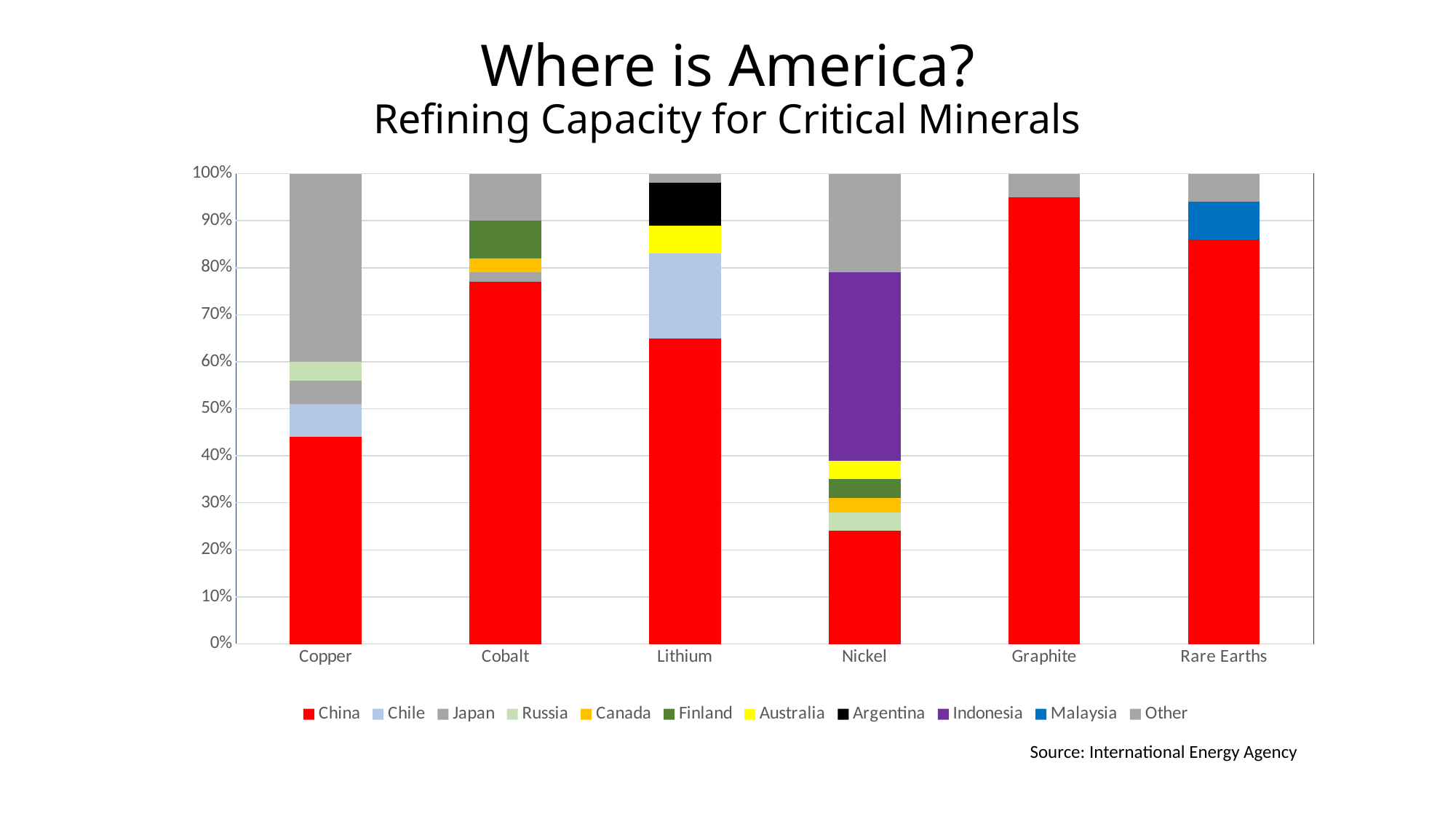
Is China's share of lithium refining capacity greater or less than 60%? greater Is China's share of copper refining capacity greater or less than 50%? less For which mineral is China's share of refining capacity the highest? Graphite What kind of chart is shown on the slide? Stacked bar chart Is China's share of nickel refining capacity greater or less than 30%? less What is the subtitle of the chart? Refining Capacity for Critical Minerals Which is larger: China's share of cobalt refining capacity or China's share of lithium refining capacity? Cobalt How many series does the legend list? 11 How many minerals are shown on the x axis? 6 What is the source cited for the chart data? International Energy Agency For which mineral is China's share of refining capacity the lowest? Nickel